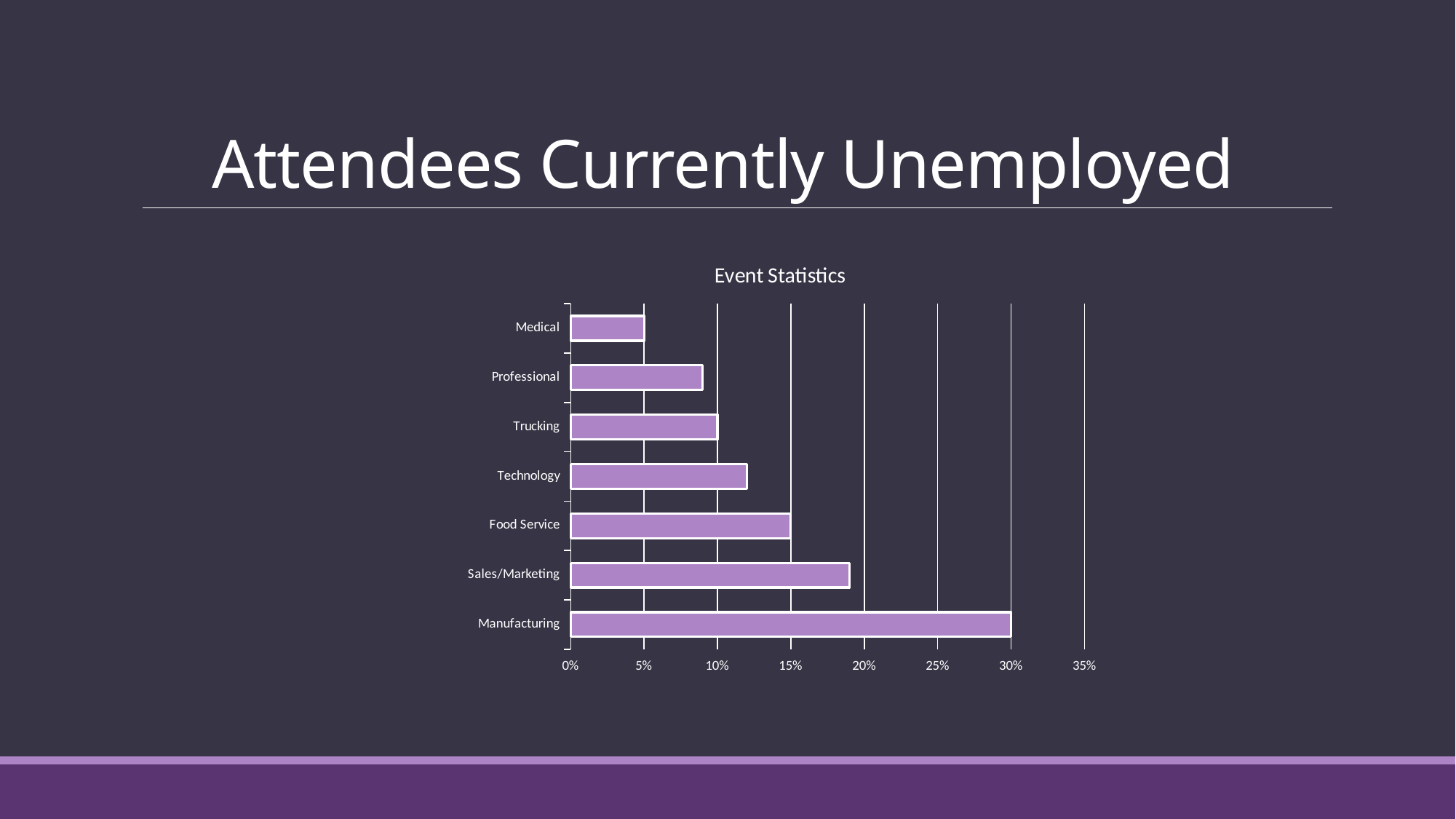
Which category has the lowest value? Medical What is the difference between the values for Manufacturing and Medical? 25% What type of chart is shown on the slide? Bar chart What is the value for Medical? 5% Is the value for Professional greater or less than 10%? less Which category has the highest value? Manufacturing What is the value for Manufacturing? 30% What is the title of the chart? Event Statistics What is the value for Food Service? 15% How many categories are shown in the chart? 7 Is the value for Technology greater or less than 10%? greater Which is larger, the value for Sales/Marketing or the value for Technology? Sales/Marketing